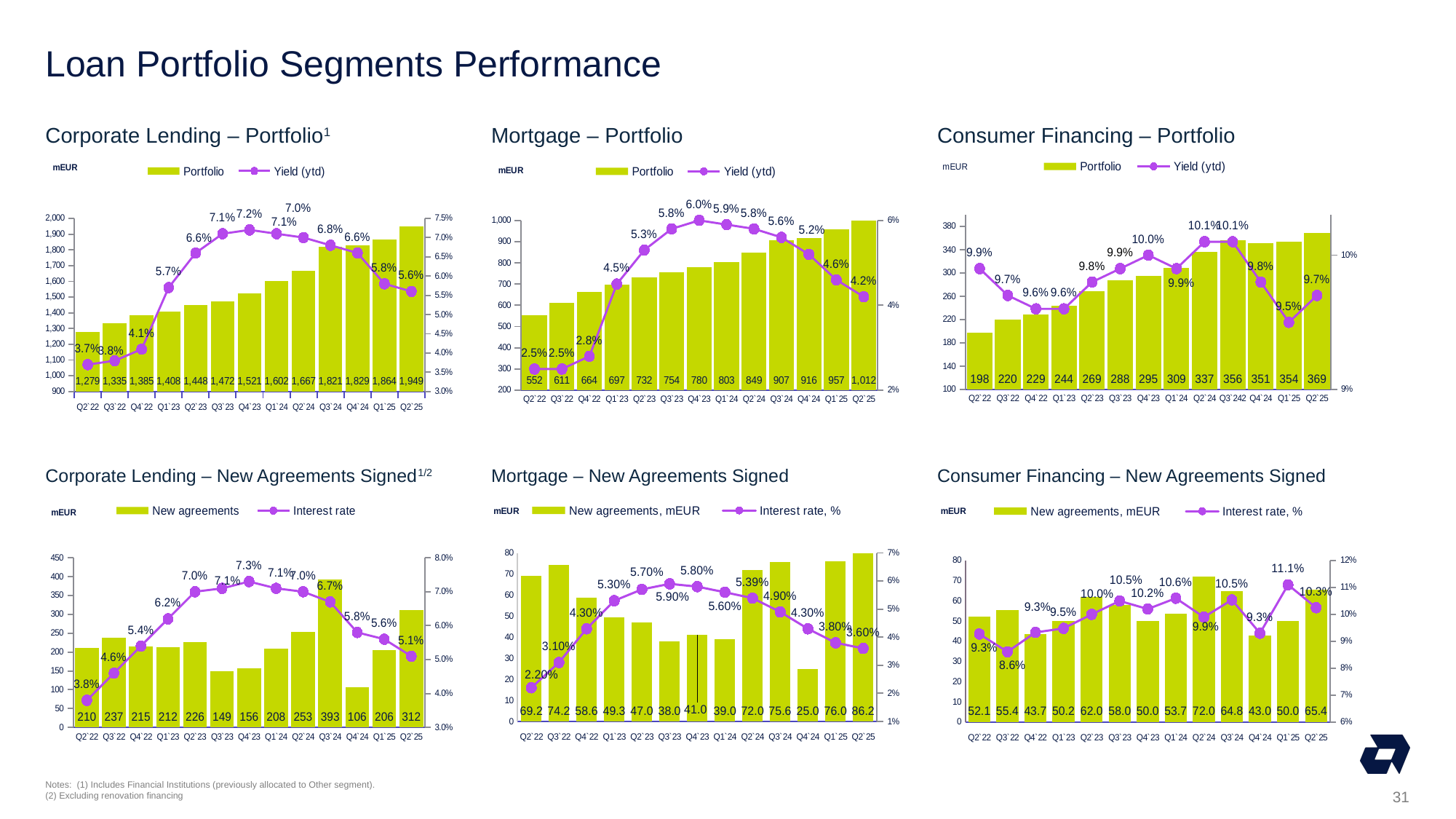
In the Mortgage – New Agreements Signed chart, what is the difference between the new agreements in Q2`25 and Q1`25? 10.2 In the Consumer Financing – New Agreements Signed chart, which is larger: the new agreements in Q2`24 or Q2`25? Q2`24 What kind of chart is the Consumer Financing – Portfolio chart? Combined bar and line chart In the Corporate Lending – Portfolio chart, how many series does the legend list? 2 In the Consumer Financing – New Agreements Signed chart, what is the interest rate for Q1`25? 11.1% In the Mortgage – Portfolio chart, what is the yield (ytd) for Q4`23? 6.0% In the Corporate Lending – New Agreements Signed chart, what is the difference between the new agreements in Q3`24 and Q4`24? 287 In the Consumer Financing – Portfolio chart, which quarter has the highest portfolio value? Q2`25 In the Corporate Lending – New Agreements Signed chart, which quarter has the lowest value of new agreements? Q4`24 In the Mortgage – Portfolio chart, does the portfolio value rise or fall from Q2`22 to Q2`25? Rise In the Corporate Lending – Portfolio chart, what is the portfolio value for Q2`25? 1,949 In the Mortgage – Portfolio chart, how many quarters are shown on the x axis? 13